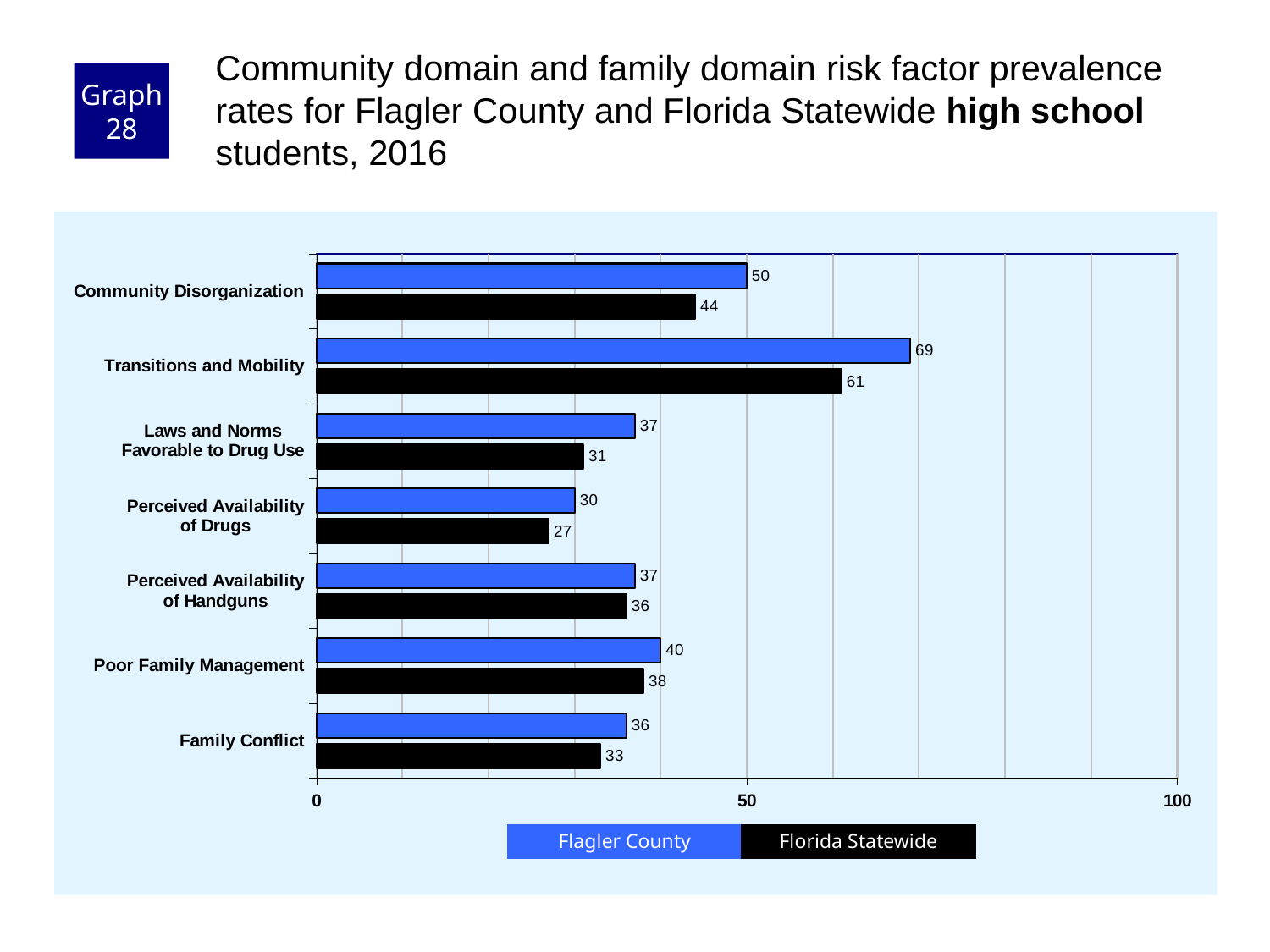
What is the Flagler County value for Transitions and Mobility? 69 How many series does the legend list? 2 What is the difference between the Flagler County and Florida Statewide values for Transitions and Mobility? 8 What is the Florida Statewide value for Perceived Availability of Drugs? 27 What kind of chart is shown on the slide? Bar chart What is the difference between the Flagler County and Florida Statewide values for Family Conflict? 3 Is the Florida Statewide value for Transitions and Mobility greater or less than 50? greater Which risk factor has the highest Flagler County value? Transitions and Mobility What is the Florida Statewide value for Community Disorganization? 44 Which risk factor has the lowest Florida Statewide value? Perceived Availability of Drugs How many risk factors are shown on the chart? 7 Which is larger for Poor Family Management, the Flagler County value or the Florida Statewide value? Flagler County